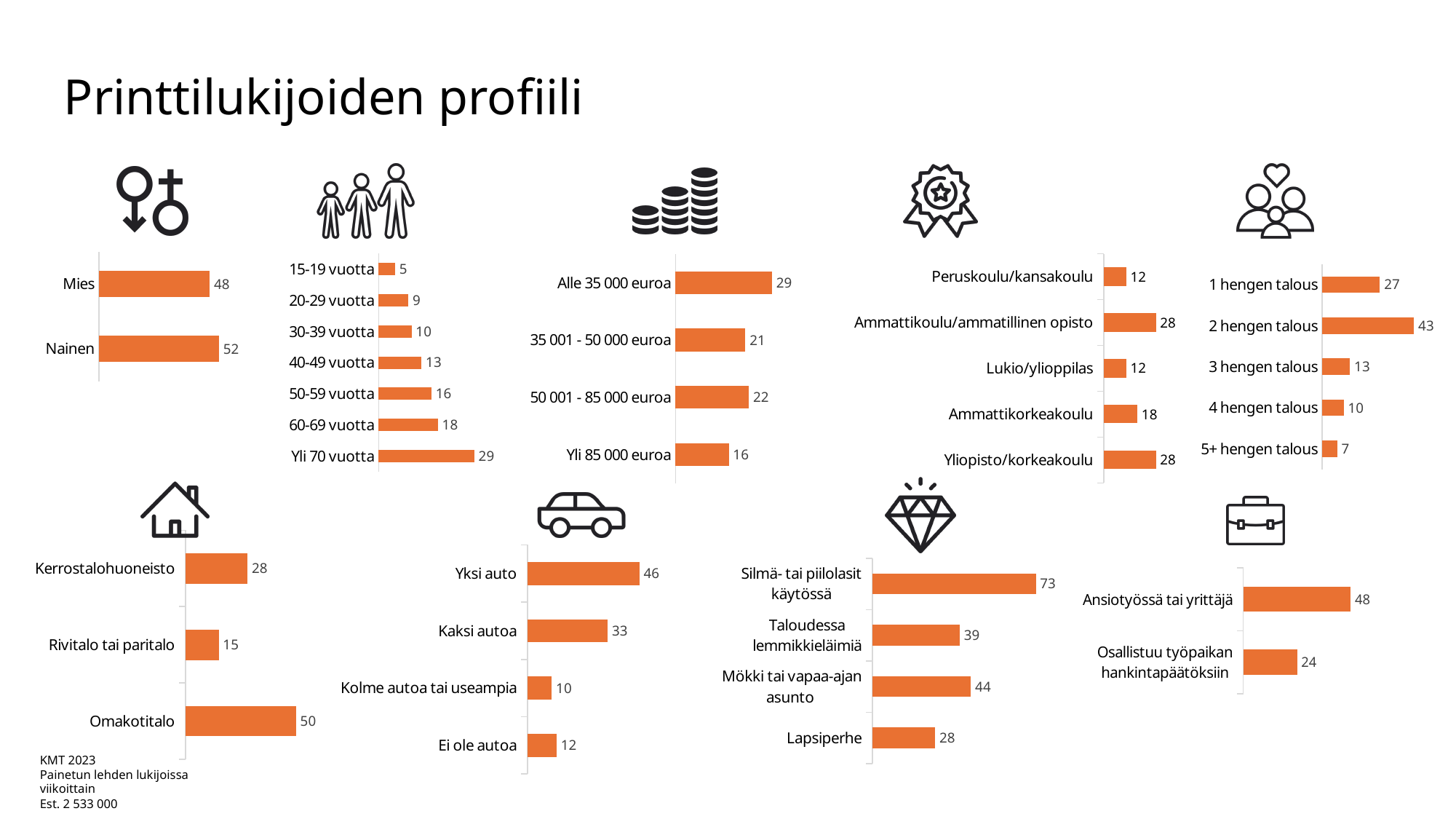
In the age chart (15-19 vuotta to Yli 70 vuotta), which age group has the highest value? Yli 70 vuotta In the age chart (15-19 vuotta to Yli 70 vuotta), which age group has the lowest value? 15-19 vuotta What type of chart is used for the gender chart at the top left (Mies/Nainen)? Bar chart In the housing type chart at the bottom left (Kerrostalohuoneisto, Rivitalo tai paritalo, Omakotitalo), which is larger: Kerrostalohuoneisto or Omakotitalo? Omakotitalo How many age categories are shown in the age chart (15-19 vuotta to Yli 70 vuotta)? 7 In the household size chart (1 hengen talous to 5+ hengen talous), which category has the highest value? 2 hengen talous In the work chart at the bottom right (Ansiotyössä tai yrittäjä, Osallistuu työpaikan hankintapäätöksiin), what is the difference between the two values? 24 In the income chart (Alle 35 000 euroa to Yli 85 000 euroa), what is the value for 50 001 - 85 000 euroa? 22 In the car ownership chart (Yksi auto to Ei ole autoa), what is the value for Kaksi autoa? 33 In the education chart (Peruskoulu/kansakoulu to Yliopisto/korkeakoulu), what is the difference between Ammattikoulu/ammatillinen opisto and Ammattikorkeakoulu? 10 In the chart with Silmä- tai piilolasit käytössä, Taloudessa lemmikkieläimiä, Mökki tai vapaa-ajan asunto and Lapsiperhe, what is the value for Mökki tai vapaa-ajan asunto? 44 In the gender chart at the top left (Mies/Nainen), what is the value for Nainen? 52